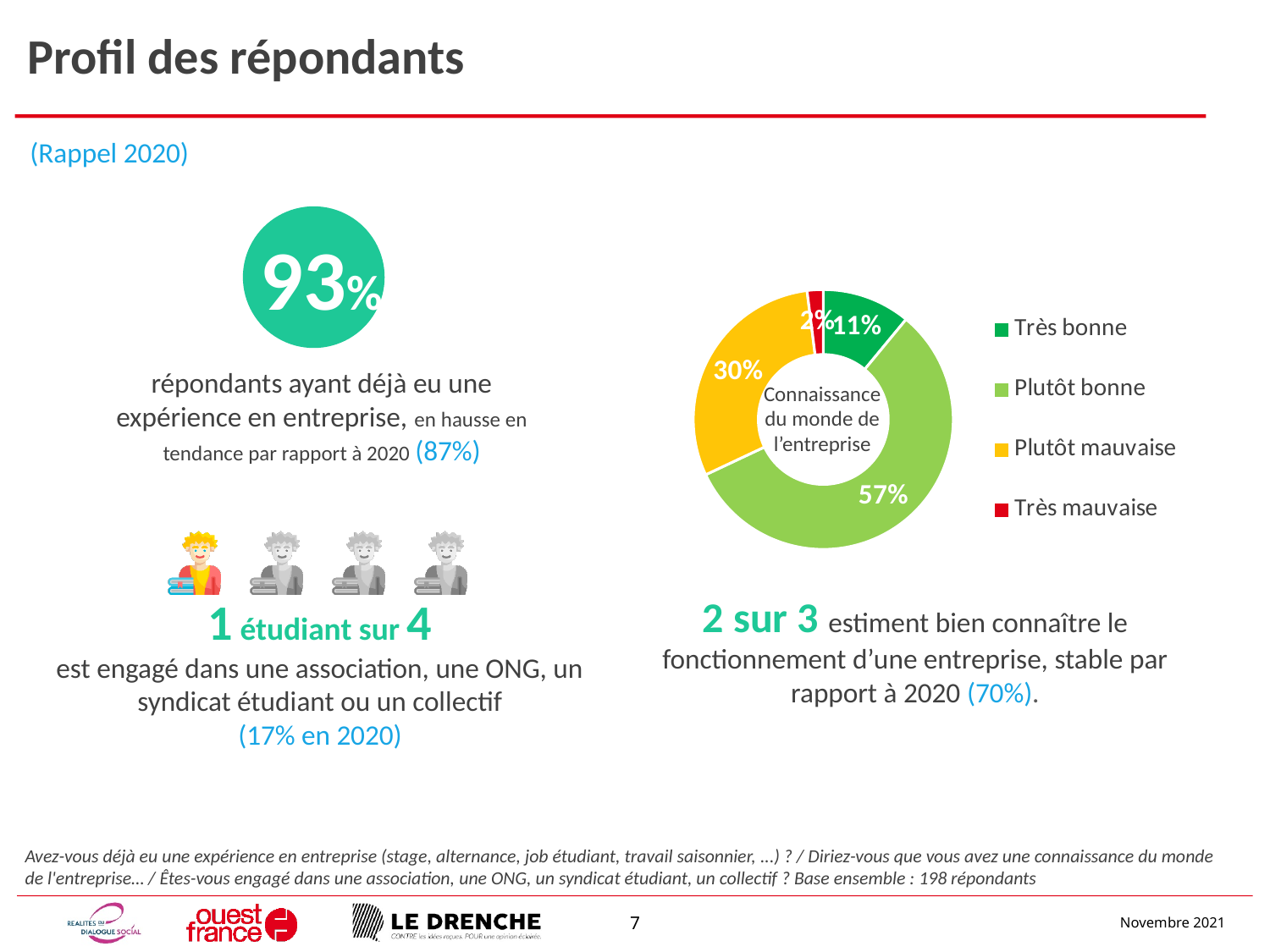
What colour is the "Plutôt mauvaise" slice in the doughnut chart? Yellow What is the value for "Très mauvaise" in the doughnut chart? 2% What is the difference between the "Plutôt bonne" and "Plutôt mauvaise" shares in the doughnut chart? 27% What text is written in the centre of the doughnut chart? Connaissance du monde de l'entreprise What is the value for "Très bonne" in the doughnut chart? 11% What kind of chart is shown on the slide? Doughnut chart What is the value for "Plutôt bonne" in the doughnut chart? 57% What is the value for "Plutôt mauvaise" in the doughnut chart? 30% Which is larger in the doughnut chart, "Très bonne" or "Plutôt mauvaise"? Plutôt mauvaise Which category has the smallest share in the doughnut chart? Très mauvaise Which category has the largest share in the doughnut chart? Plutôt bonne How many categories does the doughnut chart show? 4